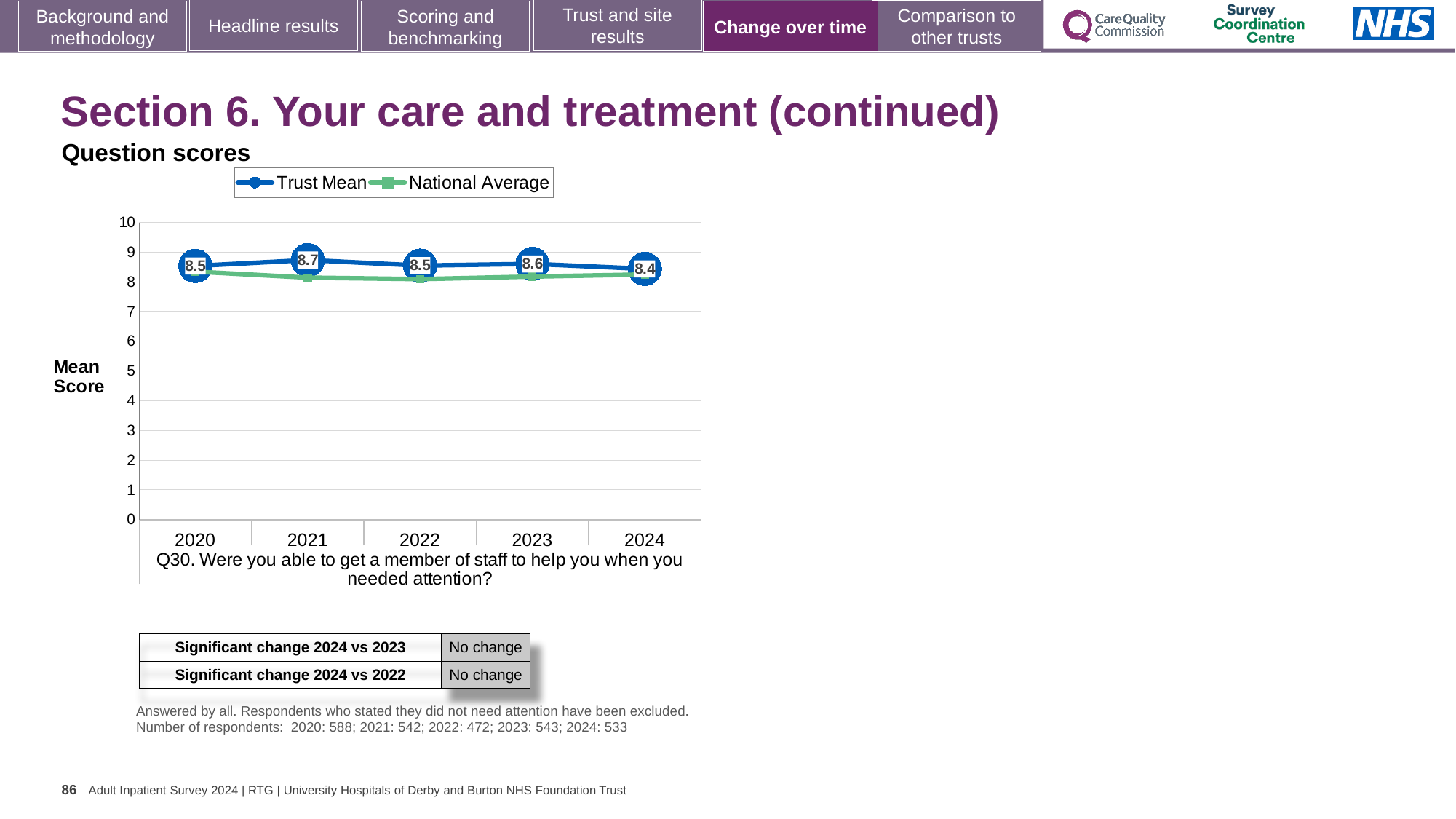
What is the Trust Mean score for 2024? 8.4 What is the difference between the Trust Mean in 2021 and in 2024? 0.3 What is the Trust Mean score for 2021? 8.7 How many series does the legend list? 2 Which is larger, the Trust Mean in 2023 or in 2024? 2023 Is the National Average value for 2022 greater or less than 9? less What kind of chart is shown? Line chart How many years are plotted on the x axis? 5 What is the Trust Mean score for 2020? 8.5 In which year is the Trust Mean lowest? 2024 In which year is the Trust Mean highest? 2021 What is the label on the y axis of the chart? Mean Score